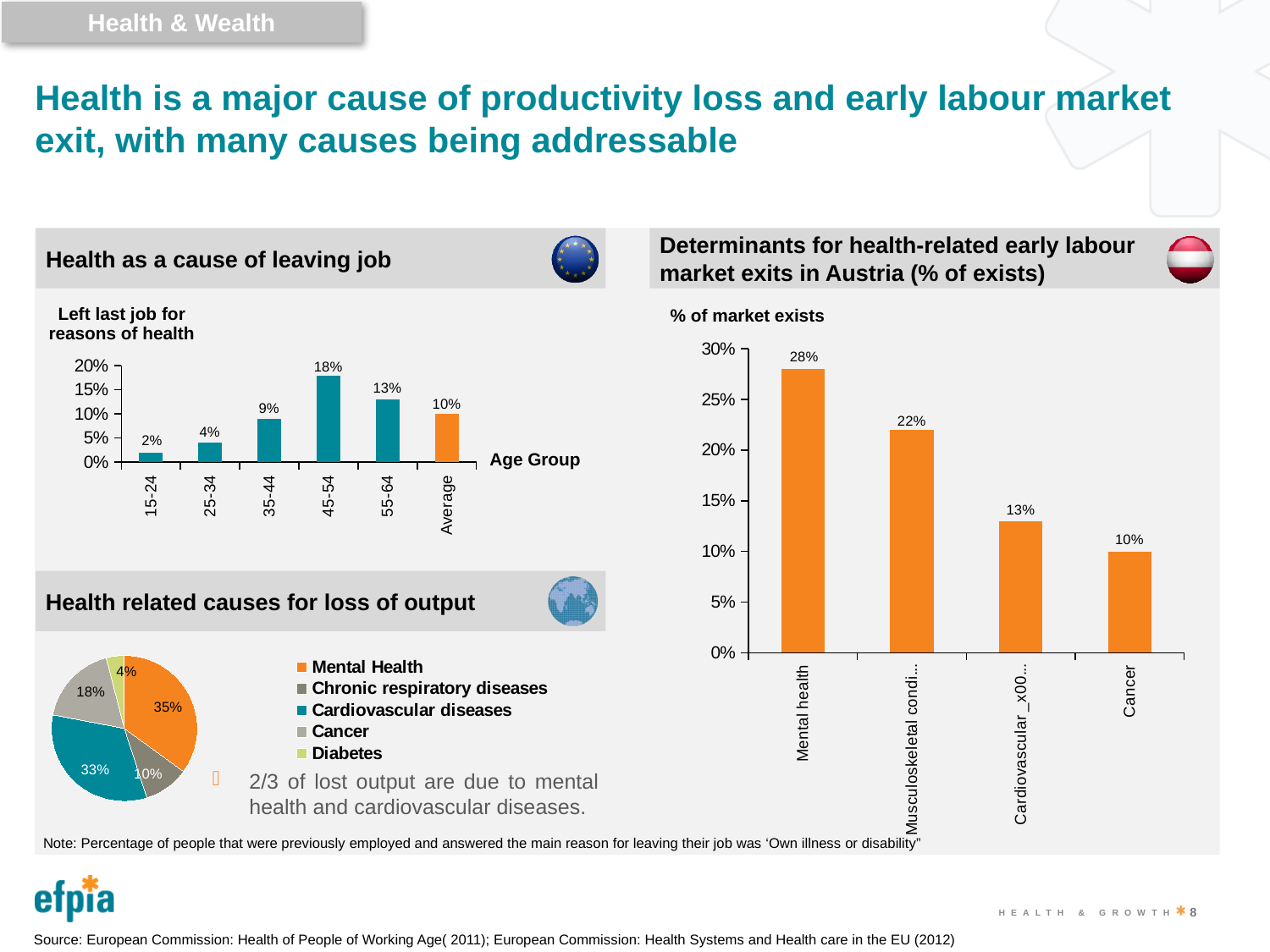
In the 'Determinants for health-related early labour market exits in Austria' chart, what is the difference between Mental health and Cancer? 18% In the 'Health as a cause of leaving job' chart, what is the value shown for Average? 10% In the 'Health as a cause of leaving job' chart, which age group has the lowest value? 15-24 In the 'Health related causes for loss of output' pie chart, what share is attributed to Cardiovascular diseases? 33% In the 'Health as a cause of leaving job' chart, what is the difference between the 45-54 and 55-64 age groups? 5% In the 'Health as a cause of leaving job' chart, which age group has the highest value? 45-54 How many categories does the legend of the 'Health related causes for loss of output' pie chart list? 5 How many age-group categories (including Average) are shown in the 'Health as a cause of leaving job' chart? 6 In the 'Determinants for health-related early labour market exits in Austria' chart, what percentage is shown for Mental health? 28% What type of chart is the 'Determinants for health-related early labour market exits in Austria' chart? Bar chart In the 'Health related causes for loss of output' pie chart, what share is attributed to Mental Health? 35% In the 'Health as a cause of leaving job' chart, what percentage is shown for the 45-54 age group? 18%